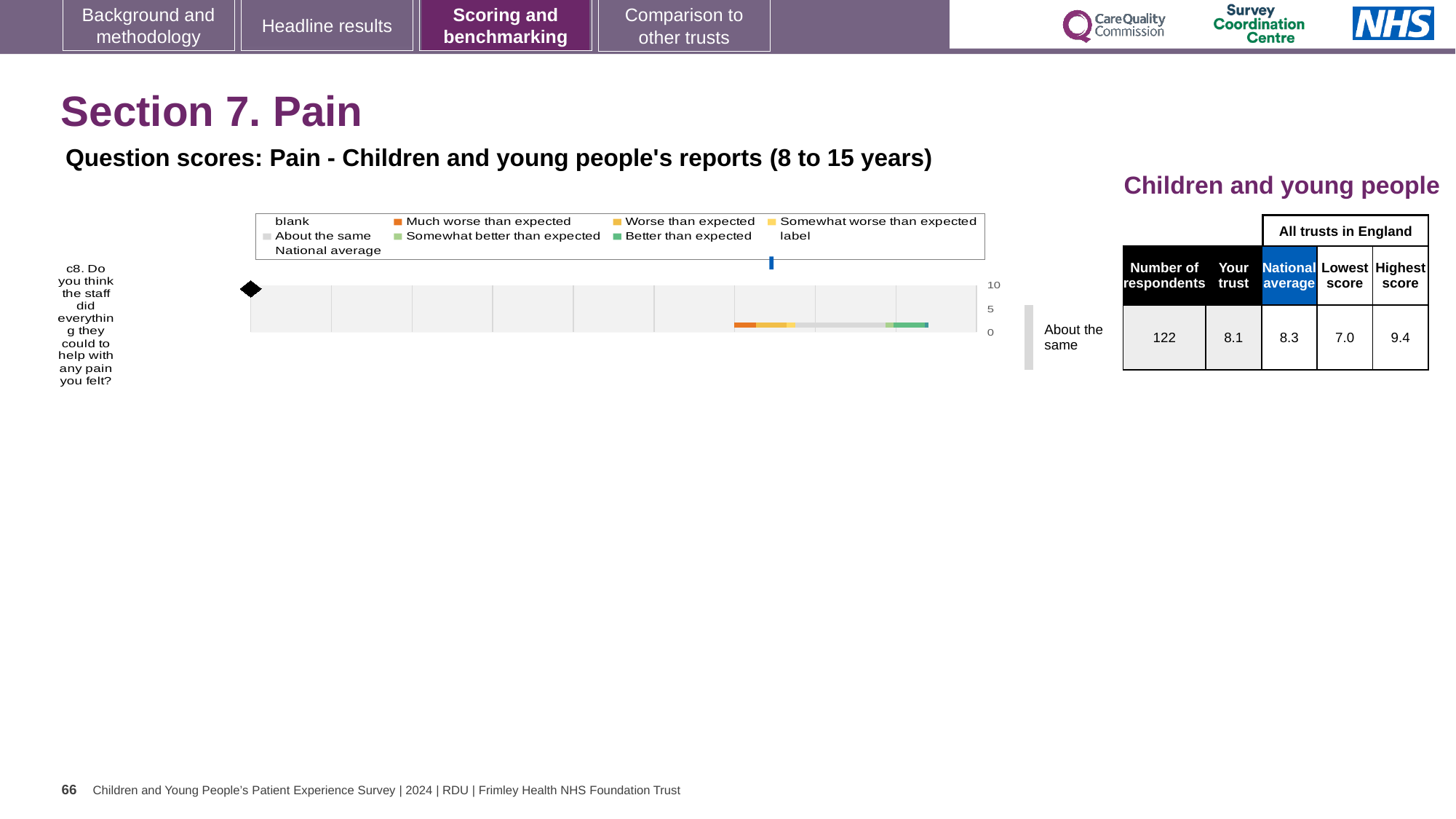
Is the 'Your trust' score for question c8 greater or less than 5? greater What kind of chart is used to show the question score for c8? bar chart What is the 'Your trust' score for question c8 about staff helping with pain? 8.1 What is the highest score among all trusts in England for question c8? 9.4 How many survey questions are plotted on the chart? 1 What is the lowest score among all trusts in England for question c8? 7.0 What is the highest tick value shown on the chart's score axis? 10 How many respondents answered question c8? 122 What is the difference between the highest score and the lowest score for question c8? 2.4 Which benchmarking category is question c8 placed in? About the same Which is larger for question c8, the 'Your trust' score or the national average? National average What is the national average score for question c8? 8.3